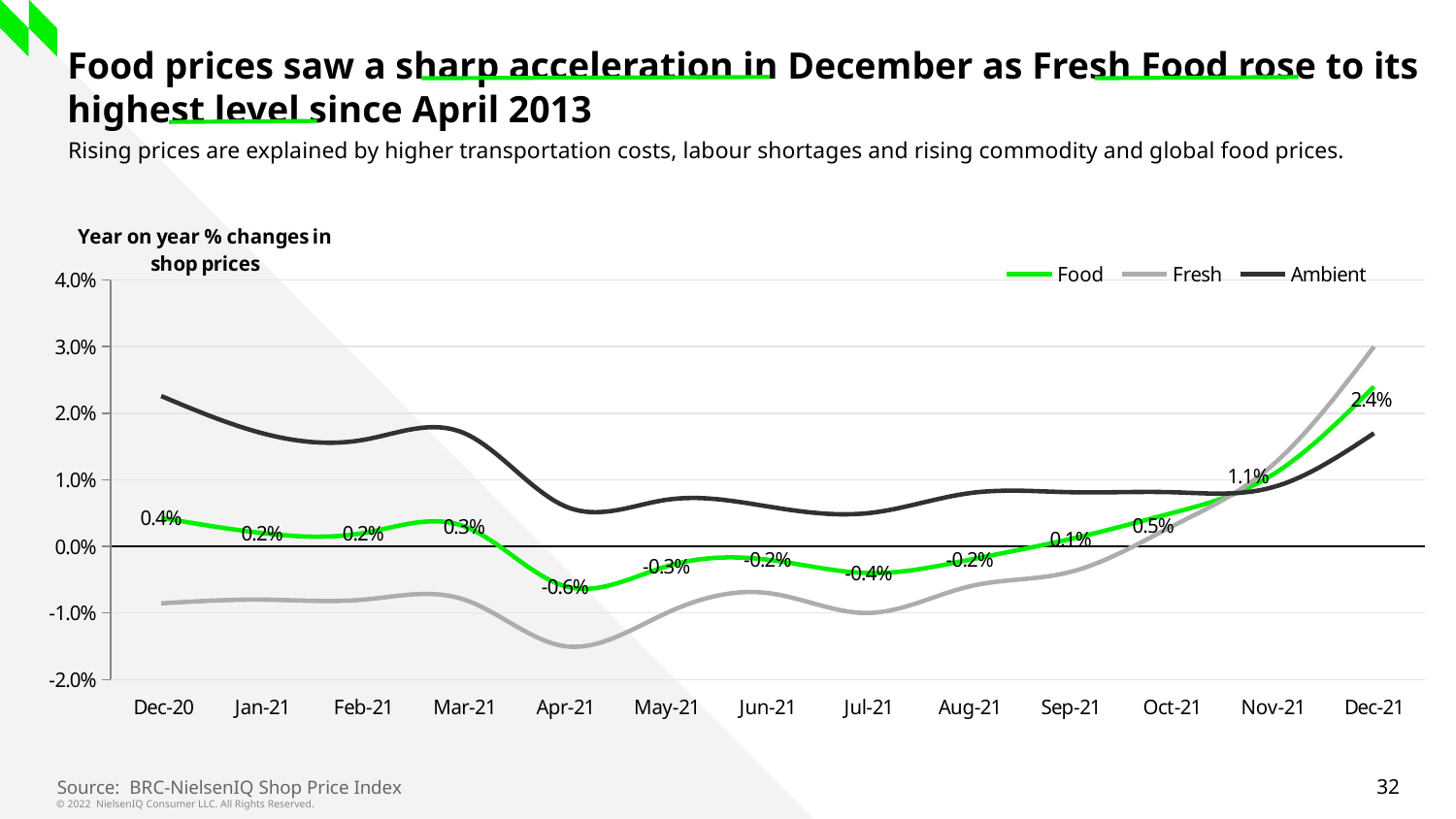
Is the Fresh value for Apr-21 greater or less than -1.0%? less What kind of chart is shown on the slide? Line chart In which month does the Food series reach its highest value? Dec-21 How many series does the legend list? 3 Is the Ambient value for Dec-20 greater or less than 2.0%? greater What is the Food value for Apr-21? -0.6% What is the difference between the Food values for Dec-21 and Nov-21? 1.3% Which is larger, the Food value for Oct-21 or for Sep-21? Oct-21 In which month does the Food series reach its lowest value? Apr-21 What is the Food value for Dec-21? 2.4% What is the Food value for Nov-21? 1.1% How many months are plotted on the x axis? 13